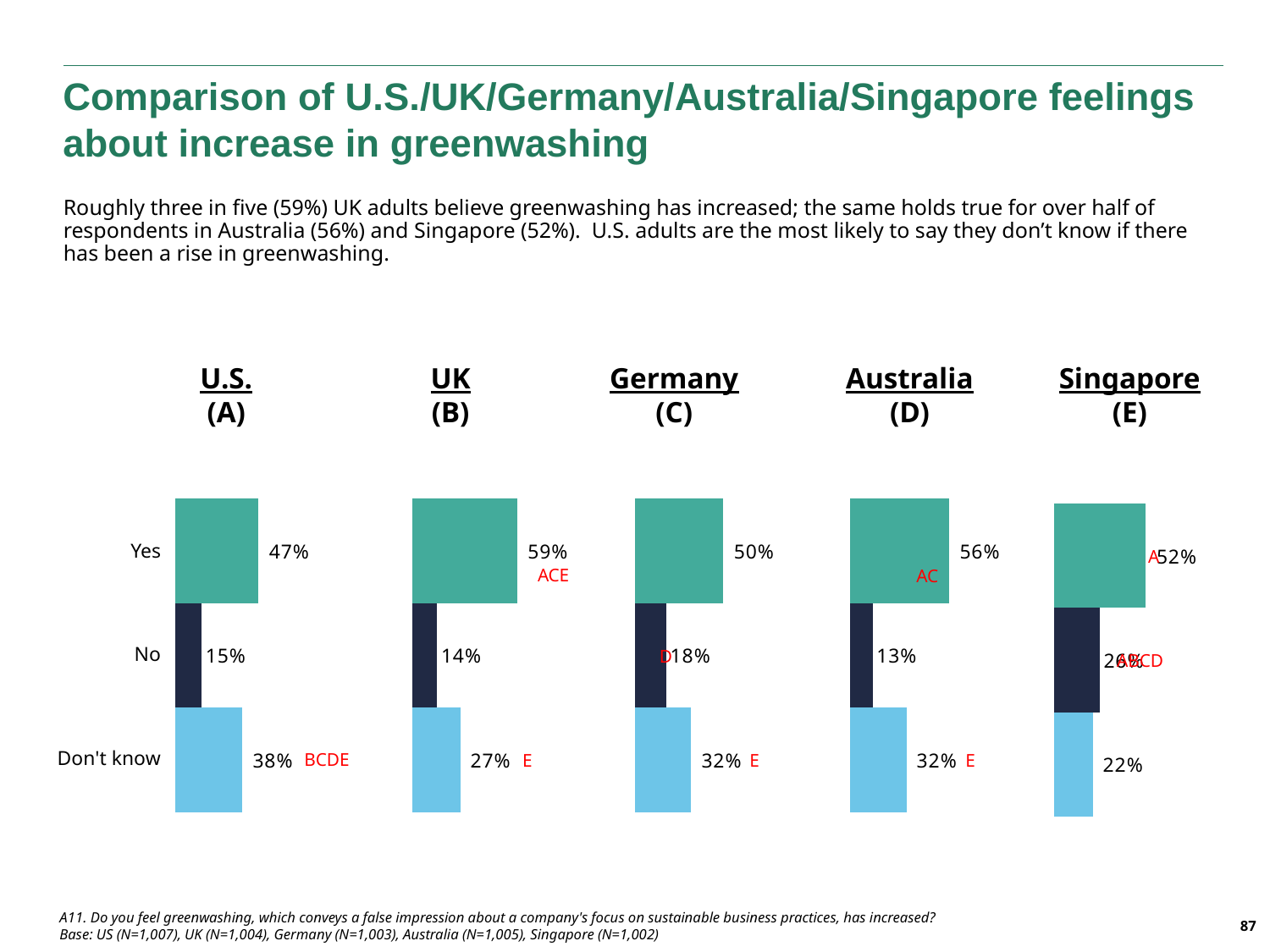
In the Australia chart, which response category has the lowest percentage? No Across the five country charts, which country has the highest "Yes" percentage? UK In the U.S. chart, what is the difference between the "Yes" and "Don't know" percentages? 9% Which is larger: the "Don't know" percentage in the U.S. chart or in the Germany chart? U.S. How many response categories are shown in each country chart? 3 In the Singapore chart, what percentage of respondents answered "Don't know"? 22% In the U.S. chart, what percentage of respondents answered "Yes"? 47% Across the five country charts, which country has the lowest "Don't know" percentage? Singapore In the Germany chart, what percentage of respondents answered "No"? 18% What kind of chart is used to show the responses for each country? Bar chart In the UK chart, what percentage of respondents answered "Don't know"? 27% In the Australia chart, what percentage of respondents answered "Yes"? 56%